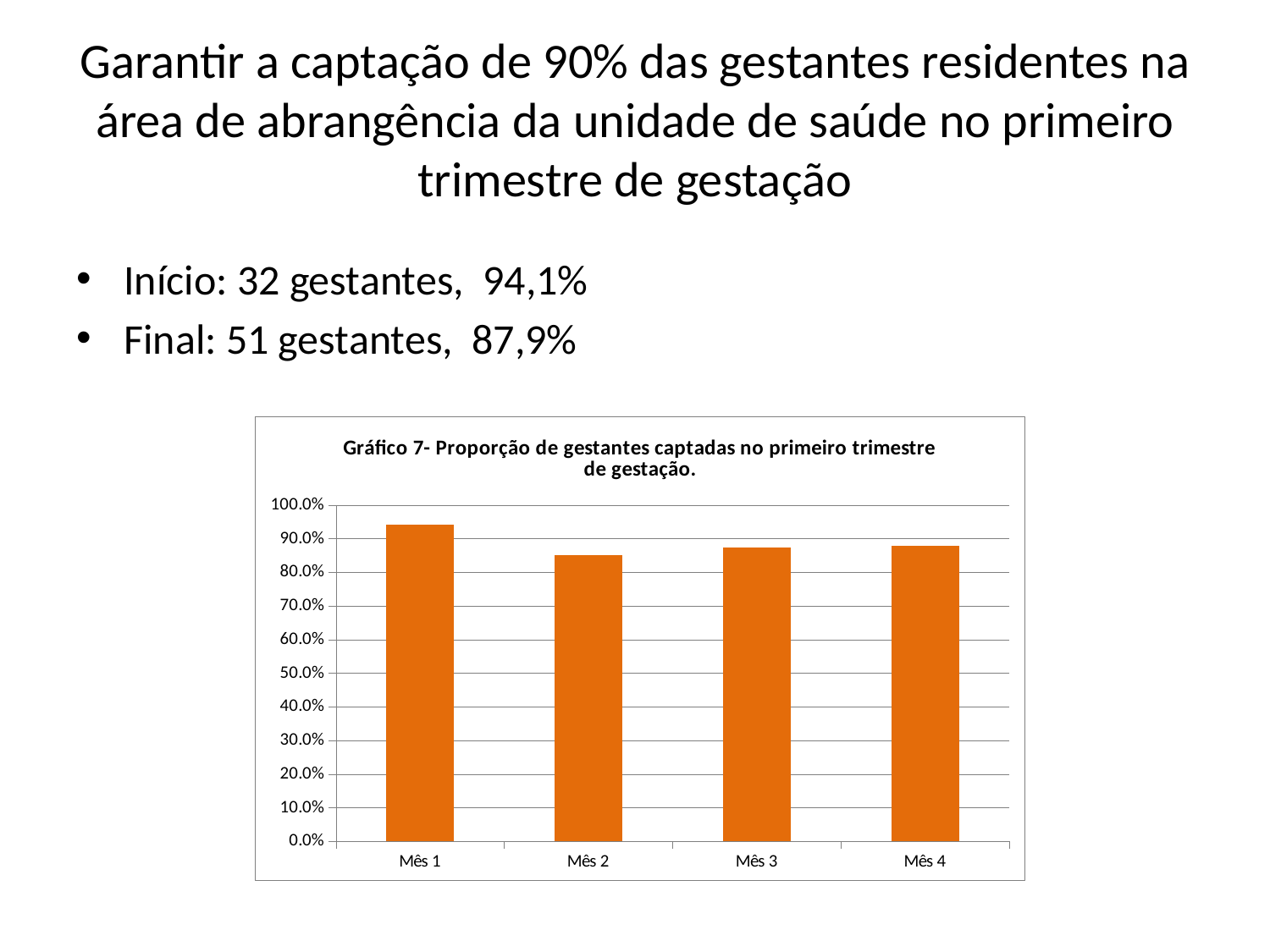
Which is larger, the value for Mês 2 or the value for Mês 4? Mês 4 Is the value for Mês 2 greater or less than 80.0%? greater Which month has the lowest proportion? Mês 2 Is the value for Mês 3 greater or less than 90.0%? less How many months (categories) are plotted on the x axis? 4 Which is larger, the value for Mês 1 or the value for Mês 2? Mês 1 Is the value for Mês 2 greater or less than 90.0%? less Which month has the highest proportion? Mês 1 What is the title of the chart? Gráfico 7- Proporção de gestantes captadas no primeiro trimestre de gestação. What kind of chart is shown on the slide? bar chart